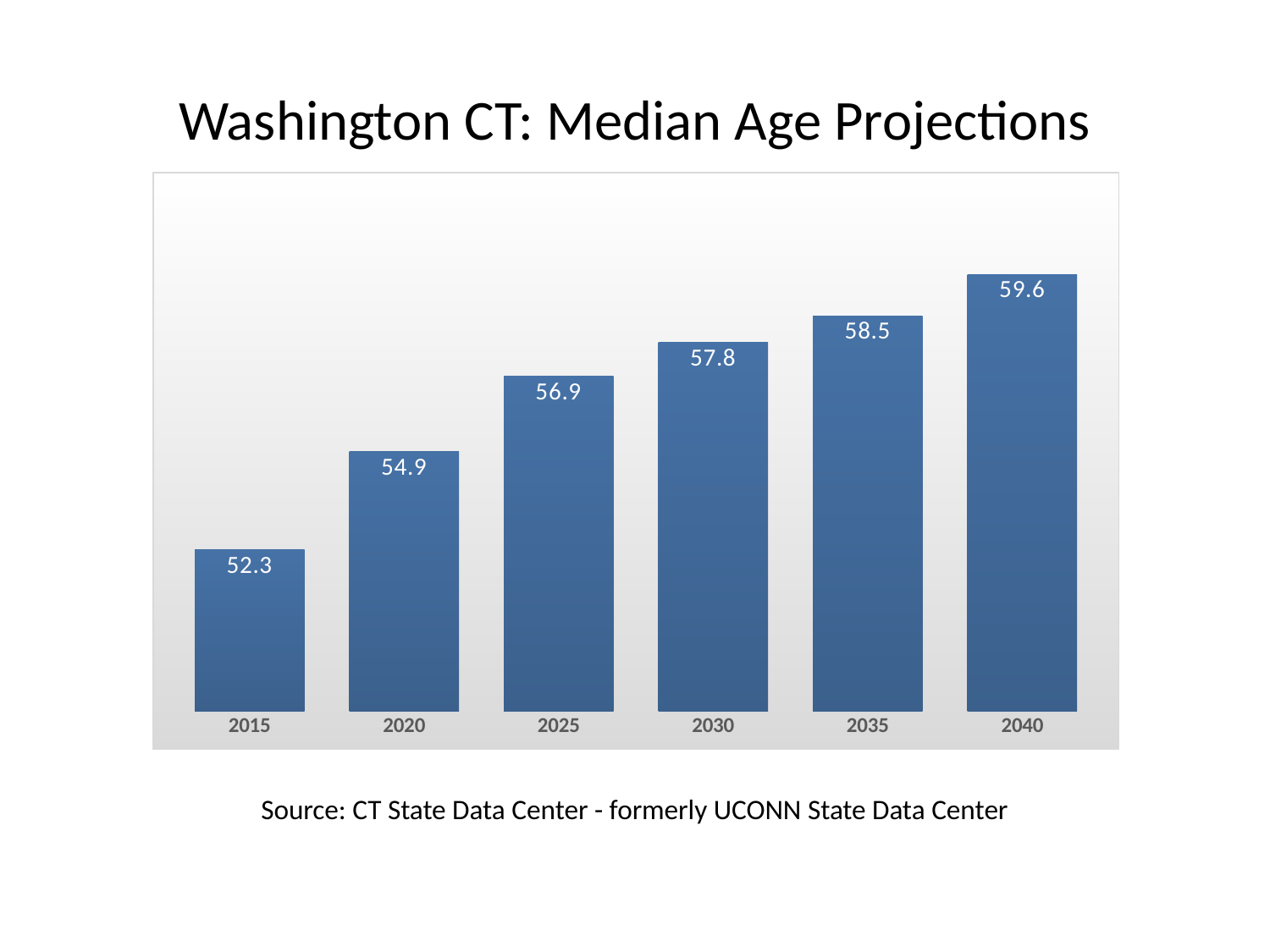
What is the difference between the projected median age in 2025 and in 2020? 2.0 What is the title of the chart? Washington CT: Median Age Projections How many years are shown on the chart? 6 What is the projected median age for 2015? 52.3 What is the difference between the projected median age in 2040 and in 2015? 7.3 Which year has the lowest projected median age? 2015 What is the projected median age for 2030? 57.8 What kind of chart is shown on the slide? Bar chart Which year has a higher projected median age, 2020 or 2035? 2035 What is the projected median age for 2040? 59.6 Do the projected median age values rise or fall from 2015 to 2040? Rise Which year has the highest projected median age? 2040